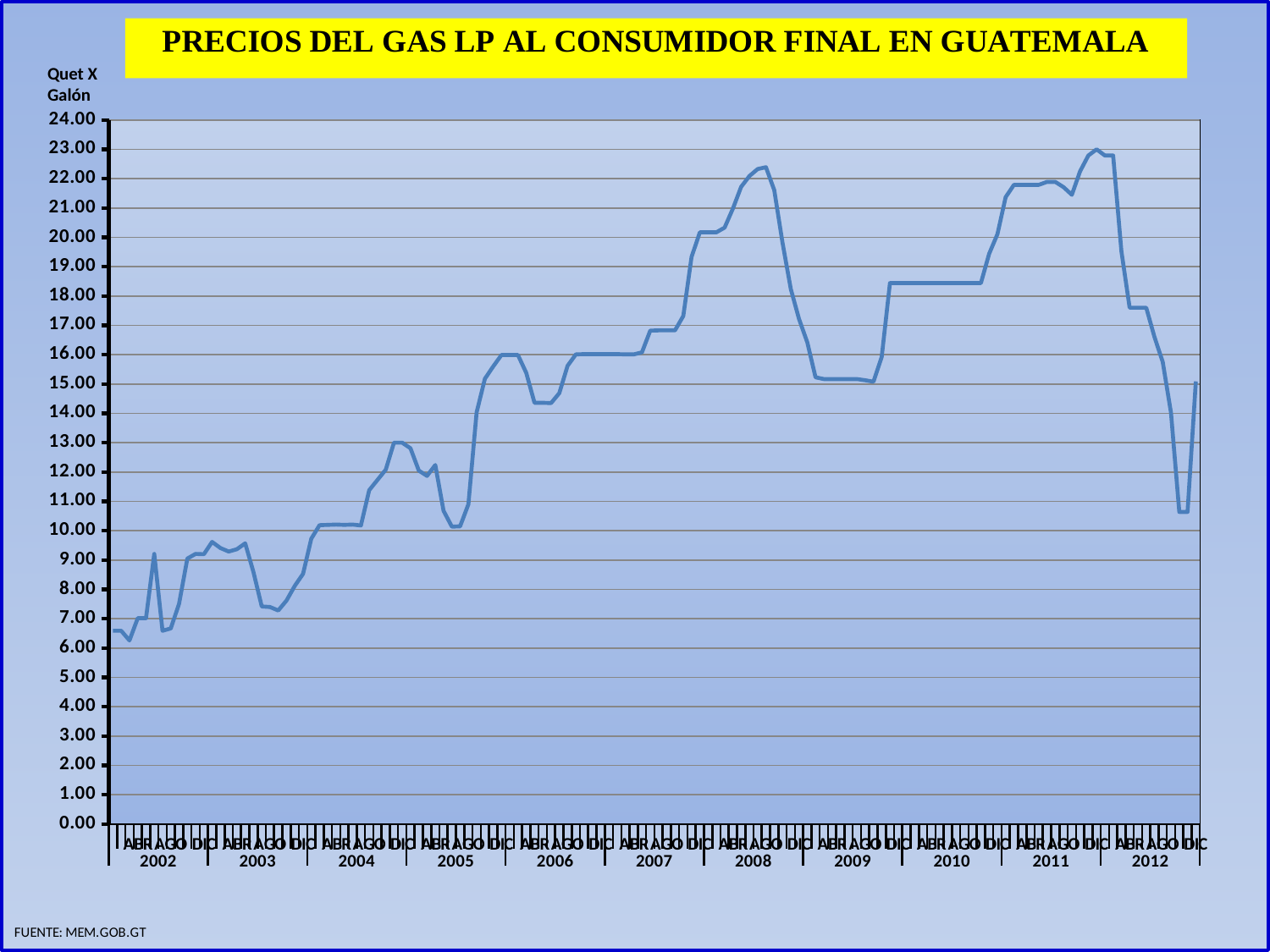
Is the peak value reached in 2011 greater or less than 22.00? greater What is the title of the chart? PRECIOS DEL GAS LP AL CONSUMIDOR FINAL EN GUATEMALA How many data series are plotted in the chart? 1 Does the price generally rise or fall from 2002 to 2011? rise In which year does the line reach its highest value? 2011 What unit is shown on the vertical axis label of the chart? Quet X Galón What kind of chart is shown on the slide? line chart Is the lowest value in late 2012 greater or less than 12.00? less Is the value at the start of 2002 greater or less than 8.00? less In which year does the line reach its lowest value? 2002 How many years are labelled along the x axis of the chart? 11